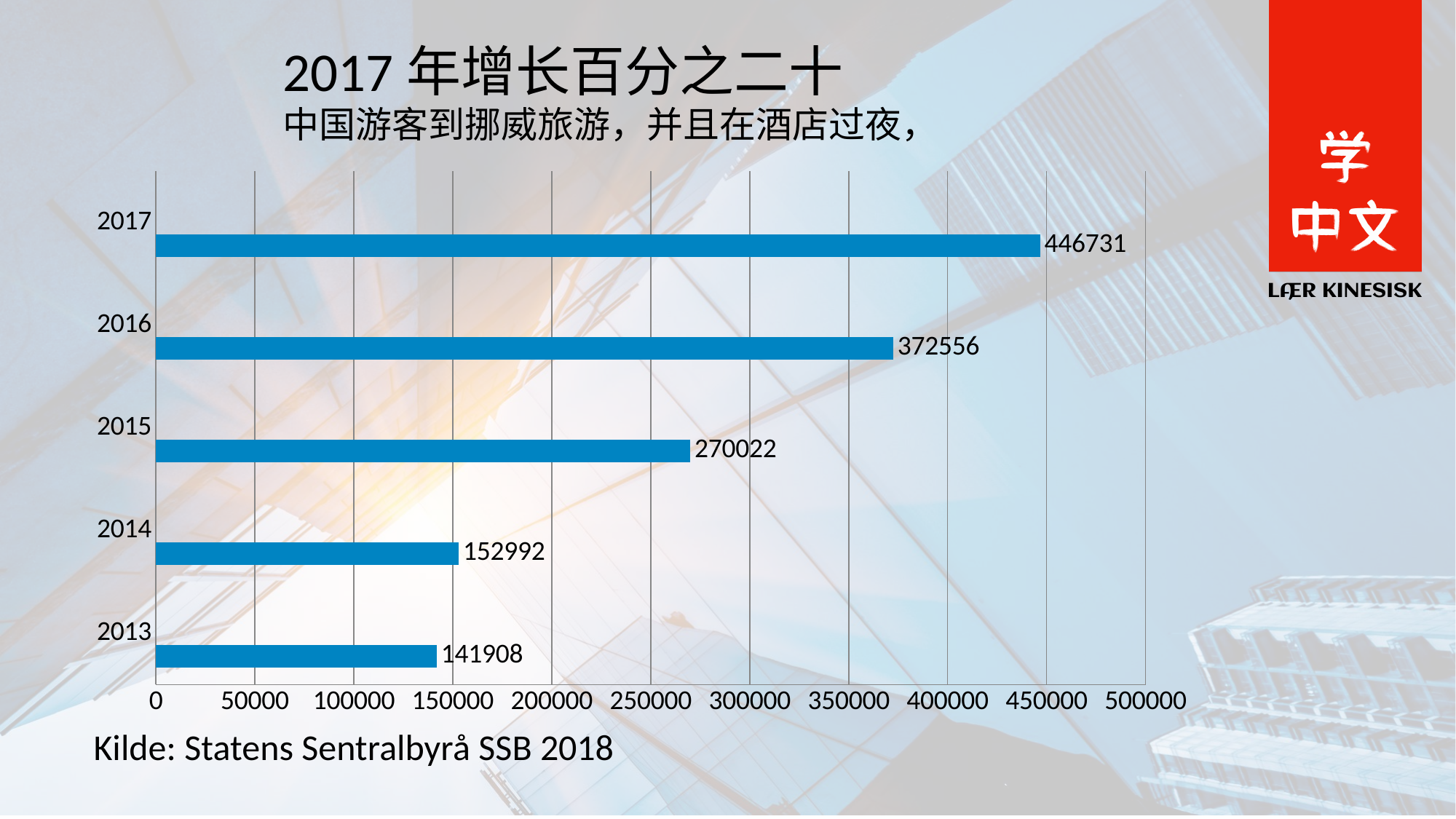
Which is larger, the value for 2016 or the value for 2015? 2016 Which year has the lowest value? 2013 What is the difference between the values for 2014 and 2013? 11084 Is the value for 2015 greater or less than 250000? greater What is the difference between the values for 2017 and 2016? 74175 What is the value for 2017? 446731 What kind of chart is shown on the slide? bar chart Do the values rise or fall from 2013 to 2017? rise What is the value for 2015? 270022 What is the value for 2013? 141908 How many years are shown in the chart? 5 Which year has the highest value? 2017